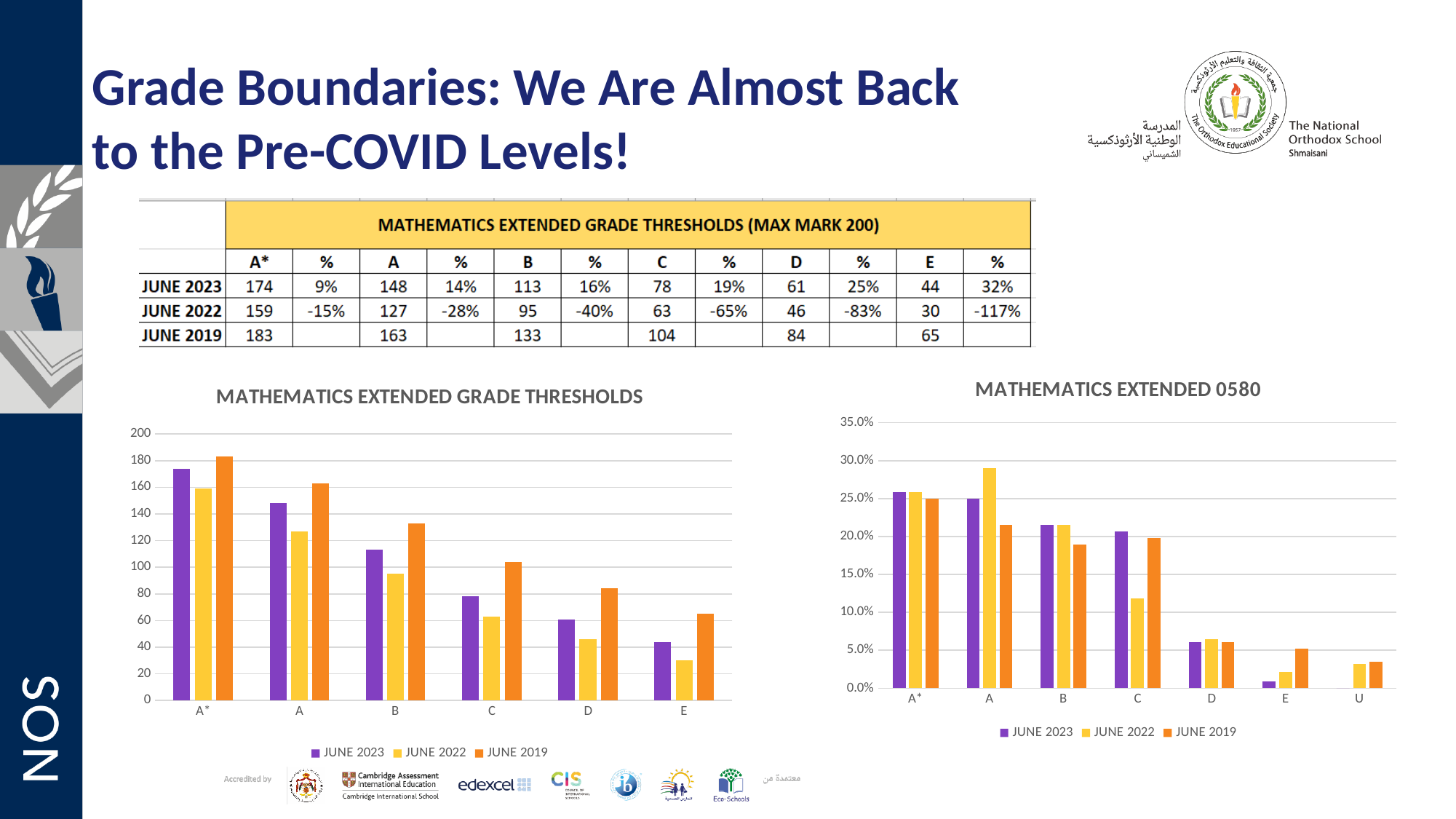
In the MATHEMATICS EXTENDED GRADE THRESHOLDS chart, which is larger for grade C: JUNE 2022 or JUNE 2019? JUNE 2019 In the MATHEMATICS EXTENDED GRADE THRESHOLDS chart, what is the difference between the JUNE 2019 and JUNE 2023 thresholds for grade B? 20 In the MATHEMATICS EXTENDED GRADE THRESHOLDS chart, do the JUNE 2023 thresholds rise or fall from A* to E? Fall In the MATHEMATICS EXTENDED GRADE THRESHOLDS chart, what is the JUNE 2019 threshold for A*? 183 In the MATHEMATICS EXTENDED GRADE THRESHOLDS chart, which grade has the highest JUNE 2023 threshold? A* How many series does the legend of the MATHEMATICS EXTENDED GRADE THRESHOLDS chart list? 3 How many grade categories are shown on the x axis of the MATHEMATICS EXTENDED GRADE THRESHOLDS chart? 6 In the MATHEMATICS EXTENDED 0580 chart, which series has the highest value for grade A? JUNE 2022 In the MATHEMATICS EXTENDED 0580 chart, is the JUNE 2022 value for grade A greater or less than 25.0%? greater What kind of chart is the MATHEMATICS EXTENDED GRADE THRESHOLDS chart on the left? Bar chart In the MATHEMATICS EXTENDED GRADE THRESHOLDS chart, is the JUNE 2022 value for grade D greater or less than 60? less How many grade categories are shown on the x axis of the MATHEMATICS EXTENDED 0580 chart on the right? 7